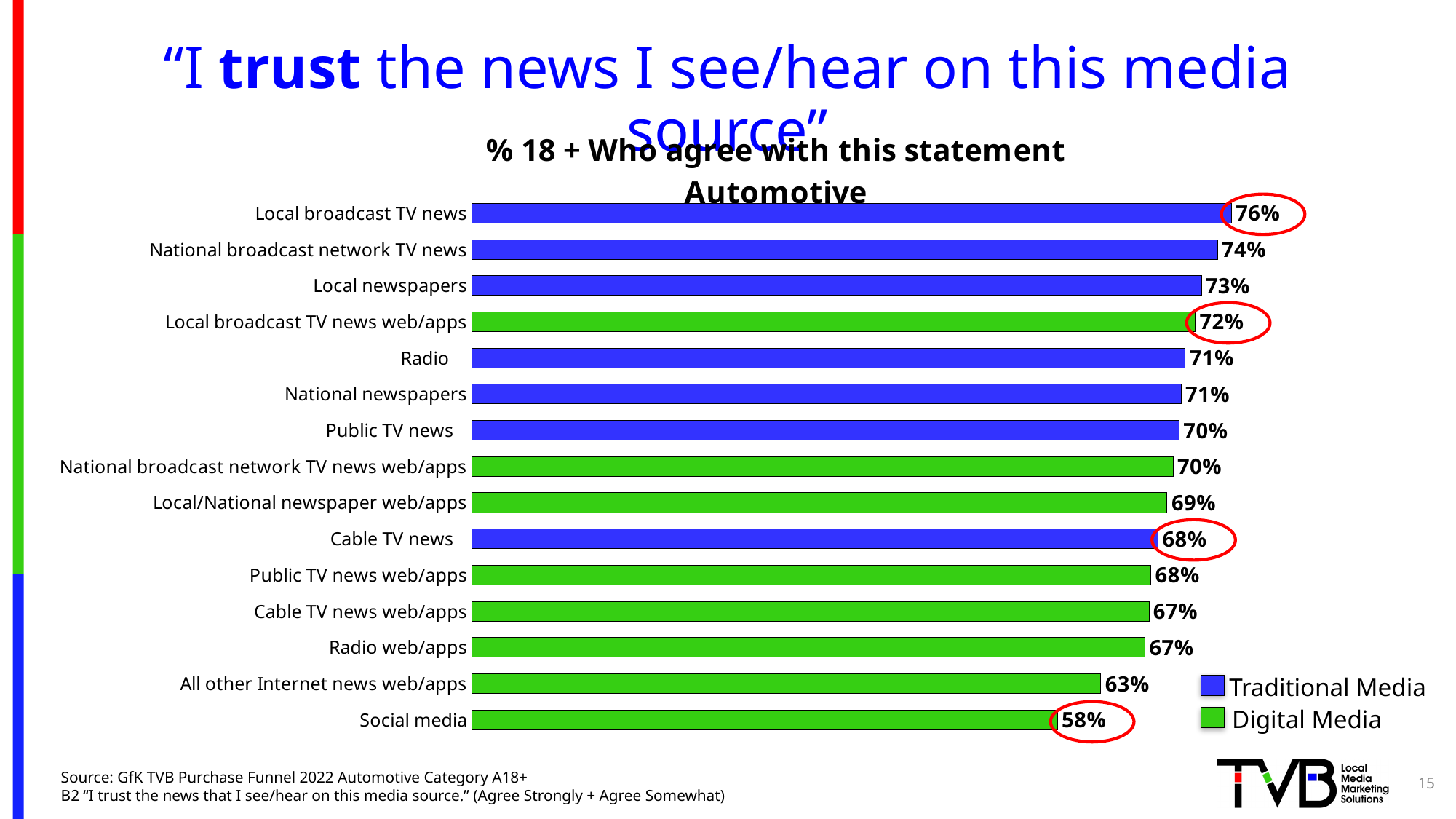
What is the difference between the values for Local broadcast TV news and Social media? 18 percentage points What type of chart is shown on the slide? Bar chart What is the value shown for Cable TV news? 68% Which media source has the lowest percentage of agreement? Social media How many series does the legend list? 2 How many media sources are shown in the chart? 15 Which colour represents Digital Media in the chart? Green What percentage of adults 18+ agree they trust the news on Local broadcast TV news? 76% What is the value shown for Social media? 58% Which media source has the highest percentage of agreement? Local broadcast TV news Which has a higher value: National broadcast network TV news or Local newspapers? National broadcast network TV news What is the value shown for Local broadcast TV news web/apps? 72%